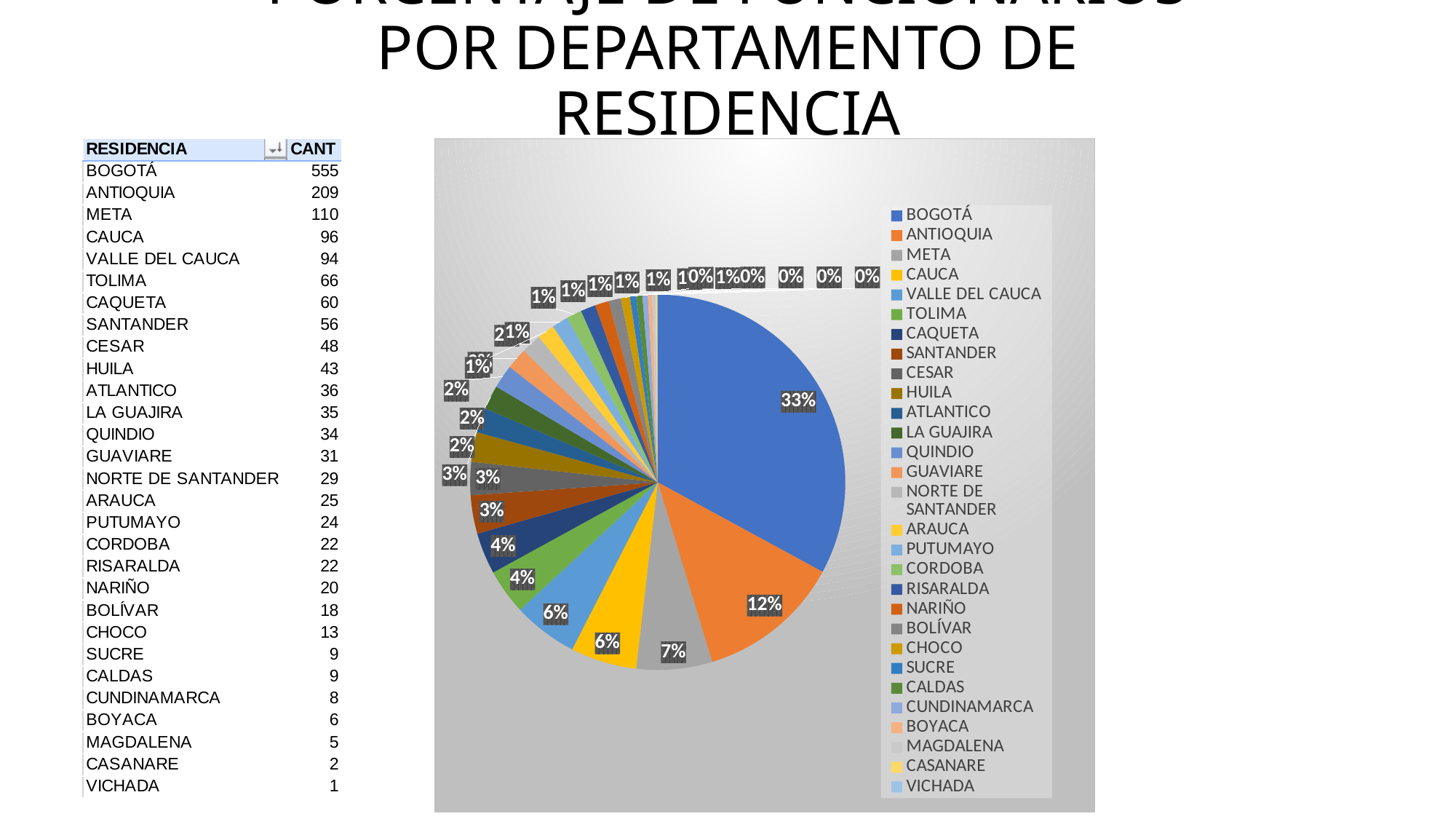
Which slice is larger, META or TOLIMA? META Which slice is larger, BOGOTÁ or ANTIOQUIA? BOGOTÁ What percentage of the pie does ANTIOQUIA account for? 12% Which department has the largest slice of the pie chart? BOGOTÁ What colour is the BOGOTÁ slice in the pie chart? blue Which department is listed first in the pie chart's legend? BOGOTÁ What percentage of the pie does BOGOTÁ account for? 33% How many departments are listed in the pie chart's legend? 29 What is the difference in percentage points between the BOGOTÁ slice and the ANTIOQUIA slice? 21 percentage points What kind of chart is shown on the slide? pie chart What percentage of the pie does META account for? 7%